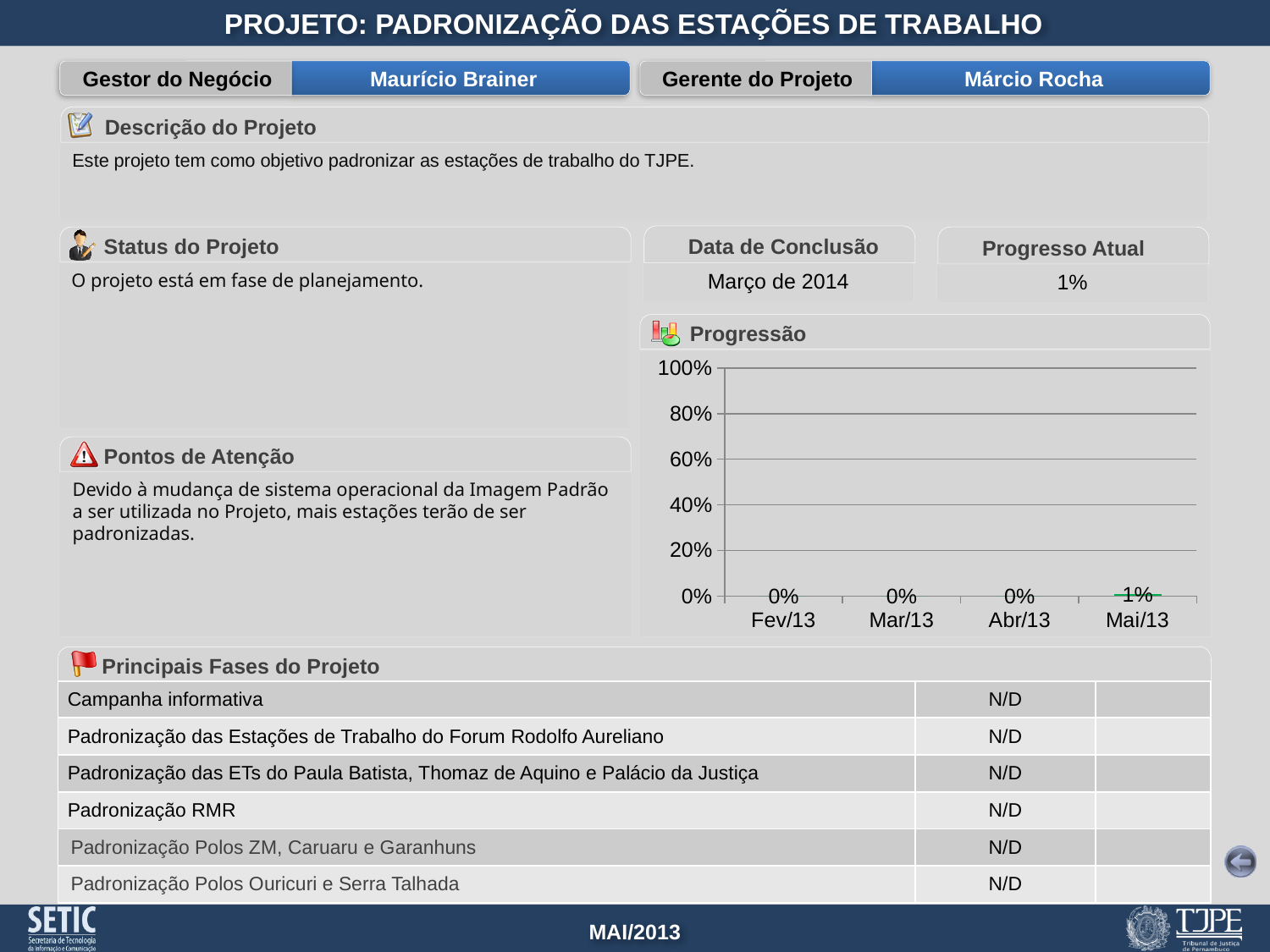
What is the title of the chart on the slide? Progressão In the Progressão chart, which is larger, the value for Mai/13 or the value for Abr/13? Mai/13 In the Progressão chart, what is the value for Fev/13? 0% In the Progressão chart, what is the value for Abr/13? 0% In the Progressão chart, what is the value for Mar/13? 0% In the Progressão chart, which month has the highest value? Mai/13 In the Progressão chart, what is the difference between the values for Mai/13 and Fev/13? 1% How many months are shown on the x axis of the Progressão chart? 4 In the Progressão chart, do the values rise or fall from Fev/13 to Mai/13? rise In the Progressão chart, what is the value for Mai/13? 1% In the Progressão chart, is the value for Mai/13 greater or less than 20%? less What is the highest value shown on the y axis of the Progressão chart? 100%